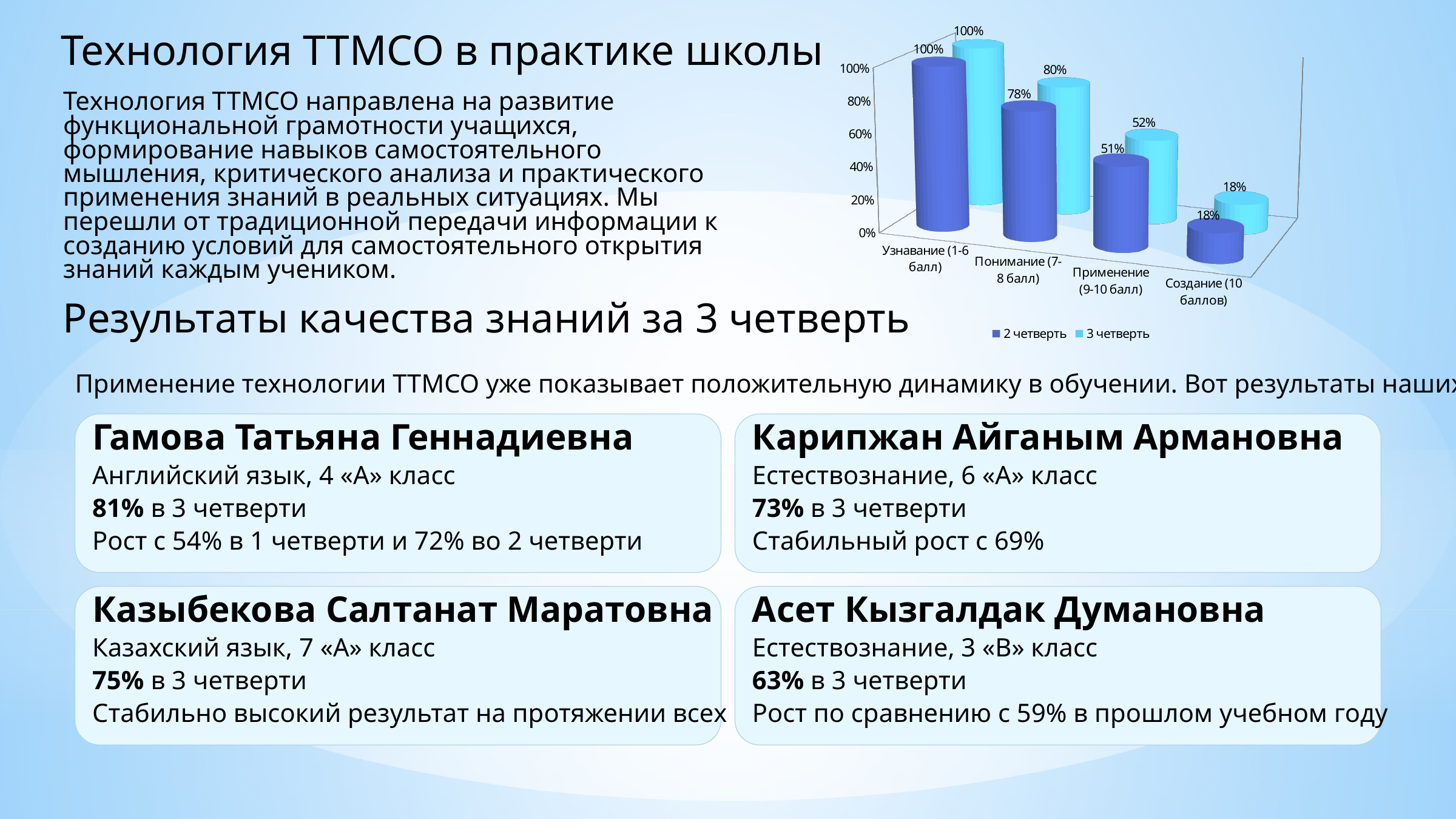
Which category has the lowest value for 3 четверть? Создание (10 баллов) How many categories are shown on the x axis of the chart? 4 What is the value for 2 четверть in the Создание (10 баллов) category? 18% What is the difference between the 2 четверть and 3 четверть values in the Понимание (7-8 балл) category? 2% What is the value for 3 четверть in the Понимание (7-8 балл) category? 80% Which category has the highest value for 2 четверть? Узнавание (1-6 балл) What kind of chart is shown on the slide? Bar chart How many series does the chart legend list? 2 Do the 3 четверть values rise or fall from Узнавание (1-6 балл) to Создание (10 баллов)? Fall What is the value for 3 четверть in the Узнавание (1-6 балл) category? 100% What is the difference between the 2 четверть values for Понимание (7-8 балл) and Применение (9-10 балл)? 27% What is the value for 2 четверть in the Применение (9-10 балл) category? 51%